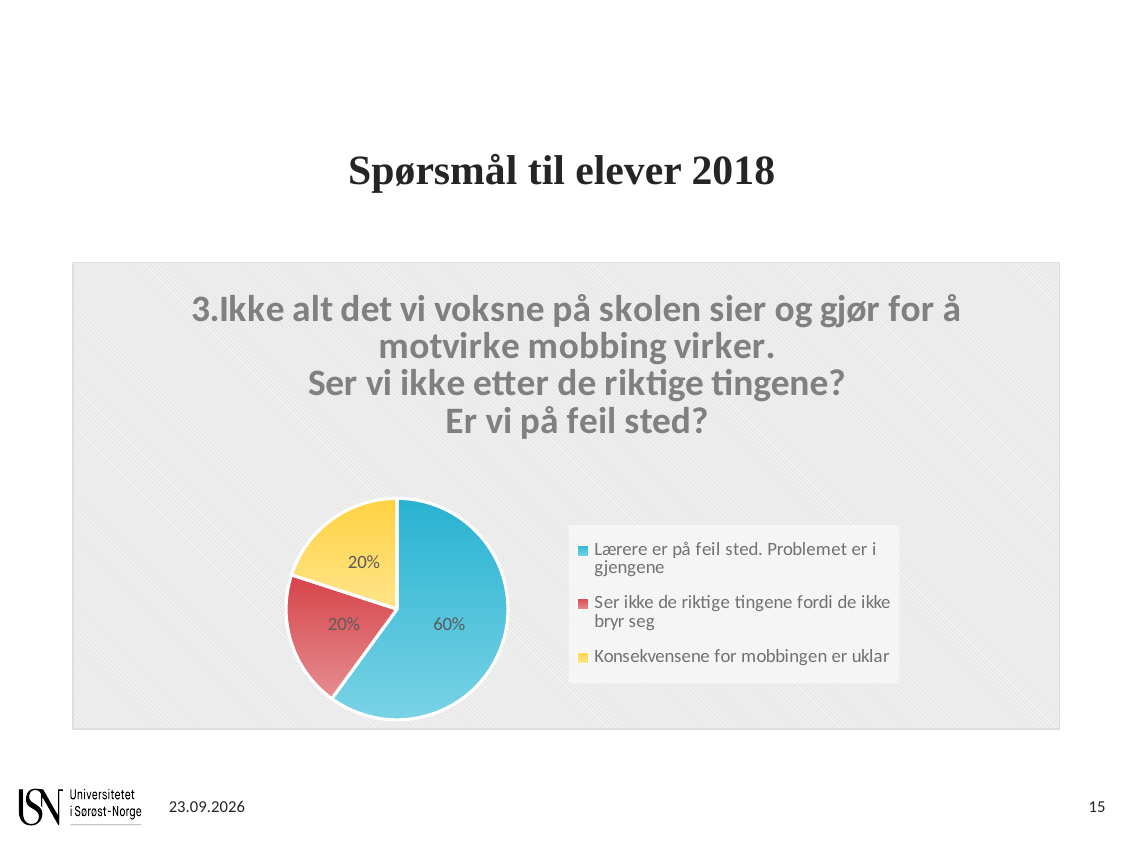
Which category has the largest slice of the pie? Lærere er på feil sted. Problemet er i gjengene What share of the pie does "Lærere er på feil sted. Problemet er i gjengene" have? 60% What share of the pie does "Ser ikke de riktige tingene fordi de ikke bryr seg" have? 20% Is the share for "Lærere er på feil sted. Problemet er i gjengene" greater or less than 50%? greater What kind of chart is shown on the slide? pie chart What share of the pie does "Konsekvensene for mobbingen er uklar" have? 20% How many entries does the legend list? 3 Which is larger: the slice for "Lærere er på feil sted. Problemet er i gjengene" or the slice for "Ser ikke de riktige tingene fordi de ikke bryr seg"? Lærere er på feil sted. Problemet er i gjengene What is the title of the slide? Spørsmål til elever 2018 What is the difference in percentage points between the "Lærere er på feil sted. Problemet er i gjengene" slice and the "Konsekvensene for mobbingen er uklar" slice? 40 percentage points What colour is the slice for "Konsekvensene for mobbingen er uklar"? yellow How many slices does the pie chart have? 3